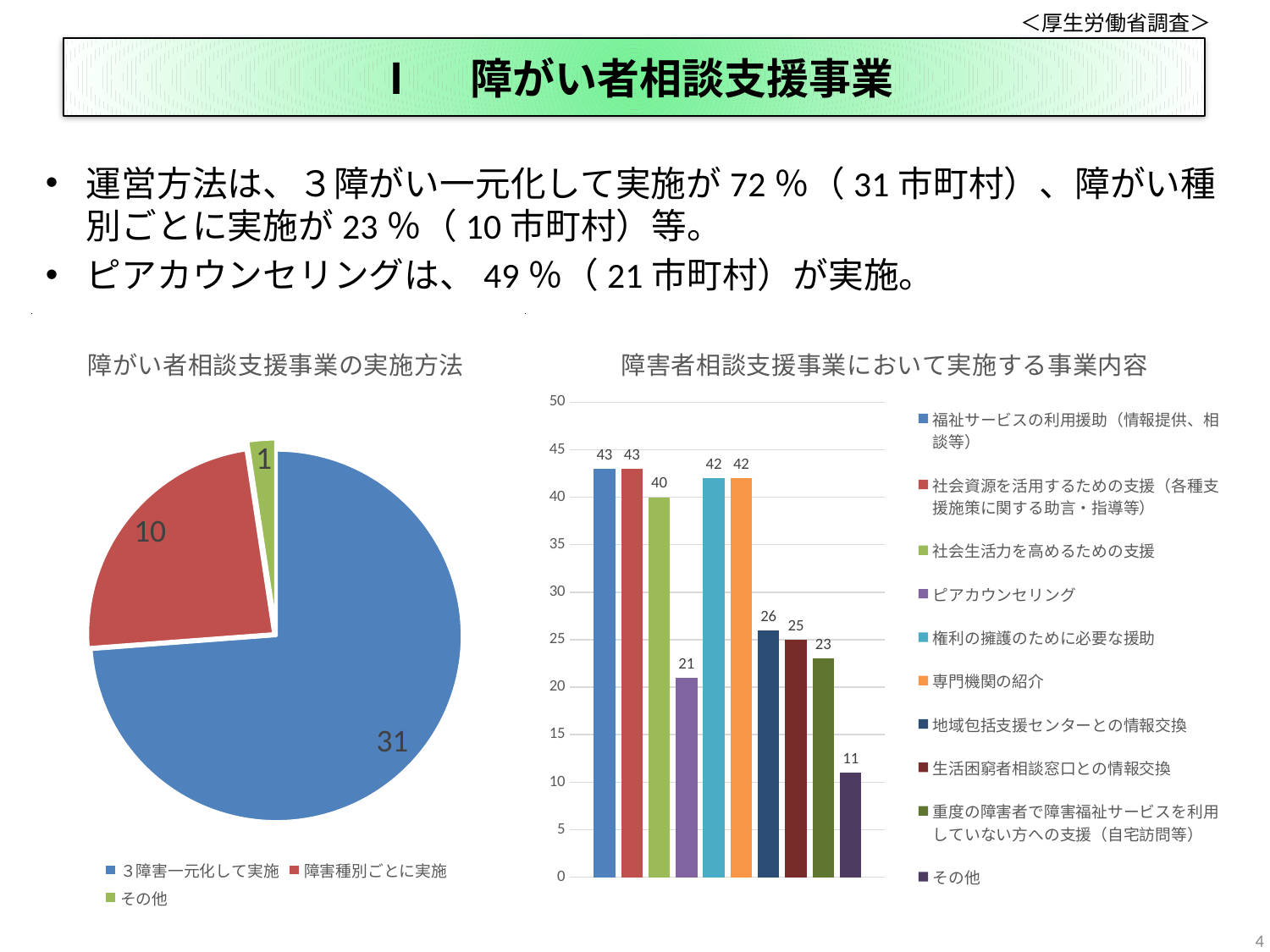
In the bar chart 障害者相談支援事業において実施する事業内容, what is the value for 社会生活力を高めるための支援? 40 In the pie chart 障がい者相談支援事業の実施方法, what is the value for 障害種別ごとに実施? 10 In the pie chart 障がい者相談支援事業の実施方法, what is the difference between ３障害一元化して実施 and 障害種別ごとに実施? 21 In the pie chart 障がい者相談支援事業の実施方法, what is the value for ３障害一元化して実施? 31 What kind of chart is 障害者相談支援事業において実施する事業内容? bar chart In the pie chart 障がい者相談支援事業の実施方法, which category has the smallest slice? その他 In the bar chart 障害者相談支援事業において実施する事業内容, which series has the lowest value? その他 In the pie chart 障がい者相談支援事業の実施方法, how many categories does the legend list? 3 In the bar chart 障害者相談支援事業において実施する事業内容, how many series does the legend list? 10 In the bar chart 障害者相談支援事業において実施する事業内容, what is the difference between 専門機関の紹介 and 生活困窮者相談窓口との情報交換? 17 In the bar chart 障害者相談支援事業において実施する事業内容, what is the value for ピアカウンセリング? 21 In the bar chart 障害者相談支援事業において実施する事業内容, which is larger: 地域包括支援センターとの情報交換 or 重度の障害者で障害福祉サービスを利用していない方への支援（自宅訪問等）? 地域包括支援センターとの情報交換